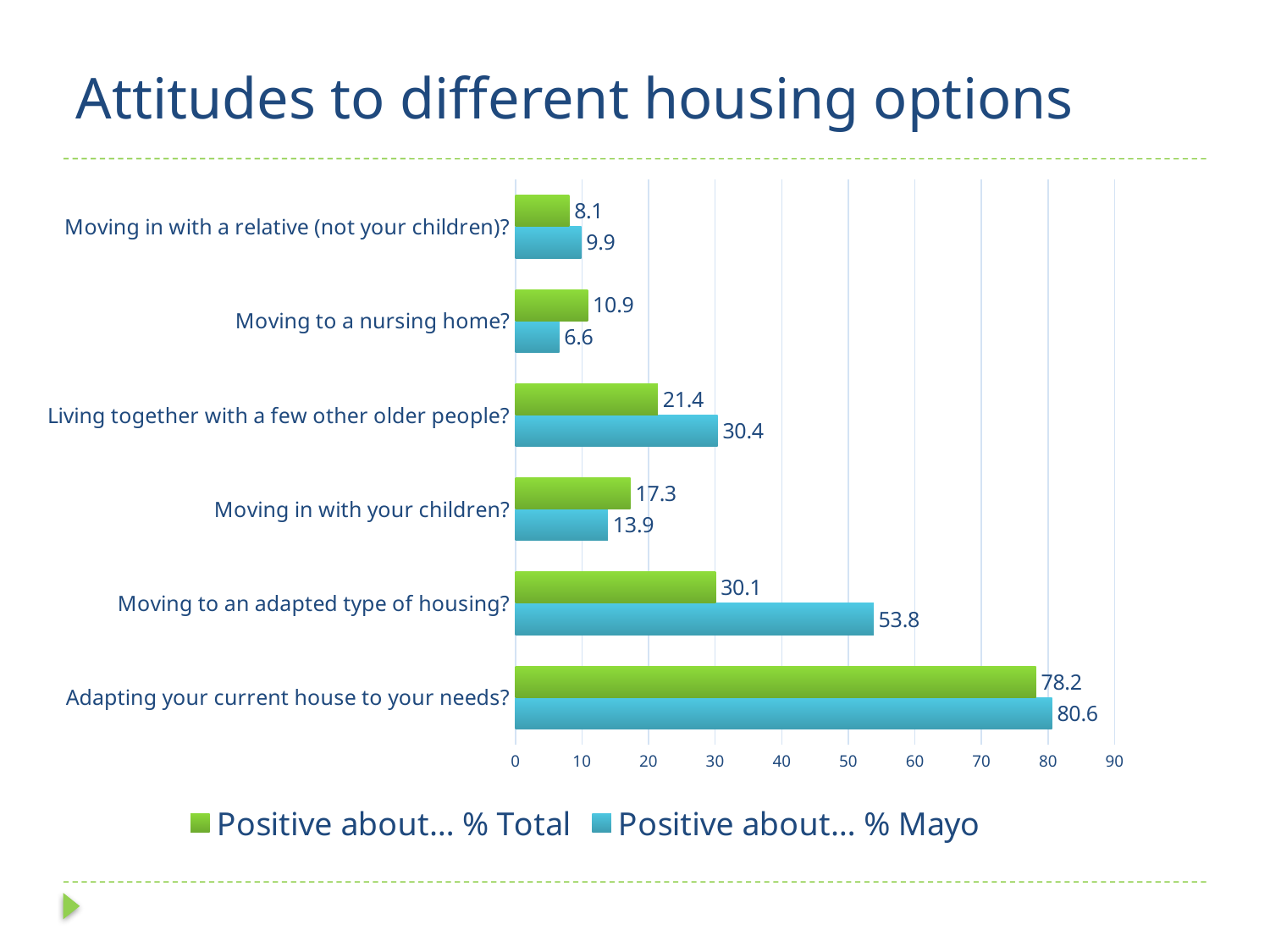
What is the value for 'Positive about... % Total' for 'Moving to an adapted type of housing?'? 30.1 How many series does the legend list? 2 What is the title of the slide? Attitudes to different housing options Which category has the lowest value for 'Positive about... % Total'? Moving in with a relative (not your children)? Which category has the highest value for 'Positive about... % Mayo'? Adapting your current house to your needs? Is the value for 'Positive about... % Mayo' for 'Adapting your current house to your needs?' greater or less than 80? greater How many categories are shown on the chart? 6 What kind of chart is shown on the slide? Bar chart What is the value for 'Positive about... % Mayo' for 'Living together with a few other older people?'? 30.4 What is the value for 'Positive about... % Mayo' for 'Moving to a nursing home?'? 6.6 For 'Moving in with your children?', which series has the larger value: 'Positive about... % Total' or 'Positive about... % Mayo'? Positive about... % Total What is the difference between the 'Positive about... % Mayo' and 'Positive about... % Total' values for 'Moving to an adapted type of housing?'? 23.7